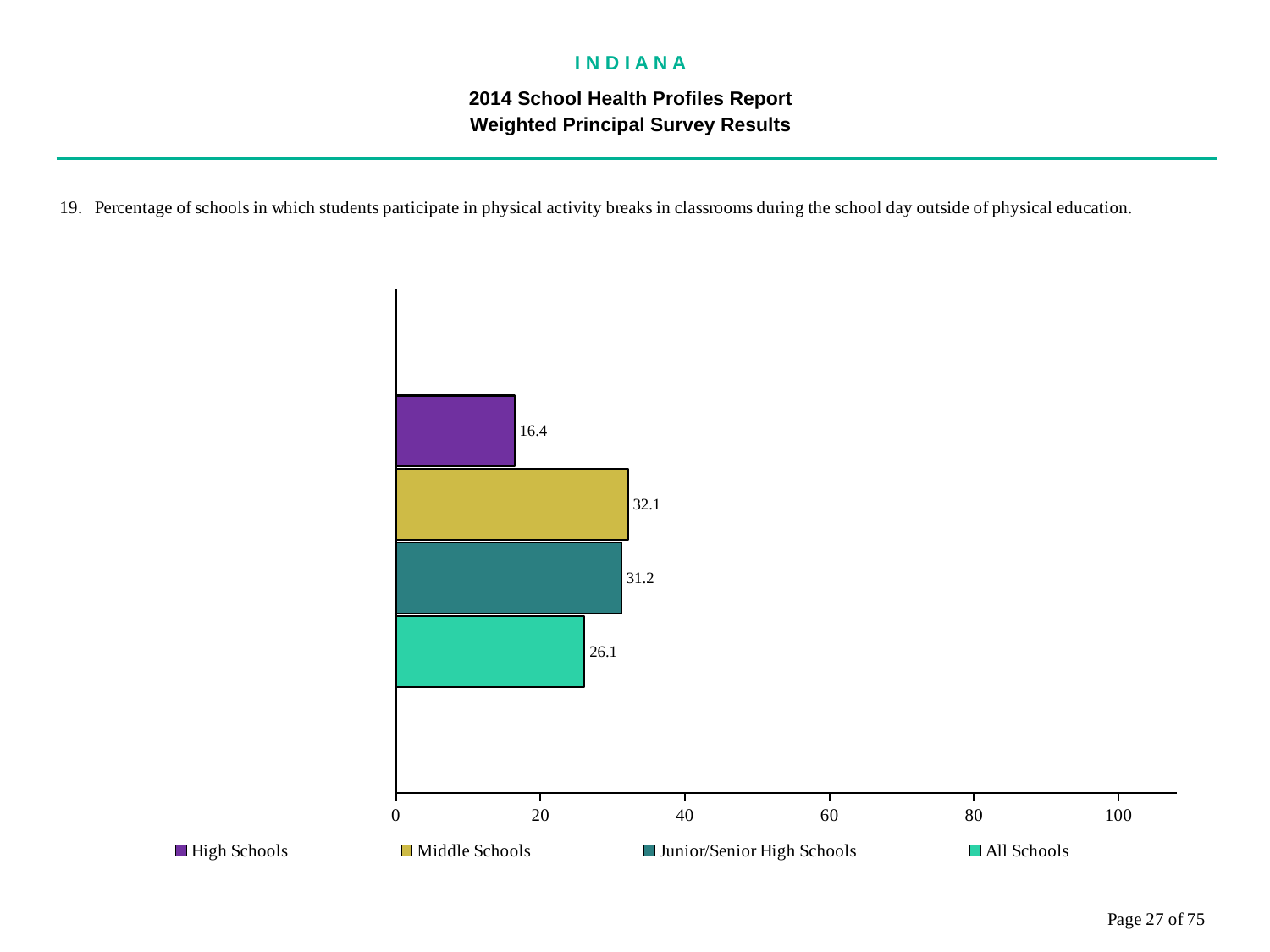
Which school type has the lowest value? High Schools What is the value for Middle Schools? 32.1 How many series does the legend list? 4 What kind of chart is shown on the slide? bar chart What is the value for All Schools? 26.1 What is the value for High Schools? 16.4 Which is larger, the value for All Schools or the value for High Schools? All Schools Is the value for Middle Schools greater or less than 40? less What is the difference between the values for Junior/Senior High Schools and All Schools? 5.1 Which school type has the highest value? Middle Schools What is the value for Junior/Senior High Schools? 31.2 What is the difference between the values for Middle Schools and High Schools? 15.7